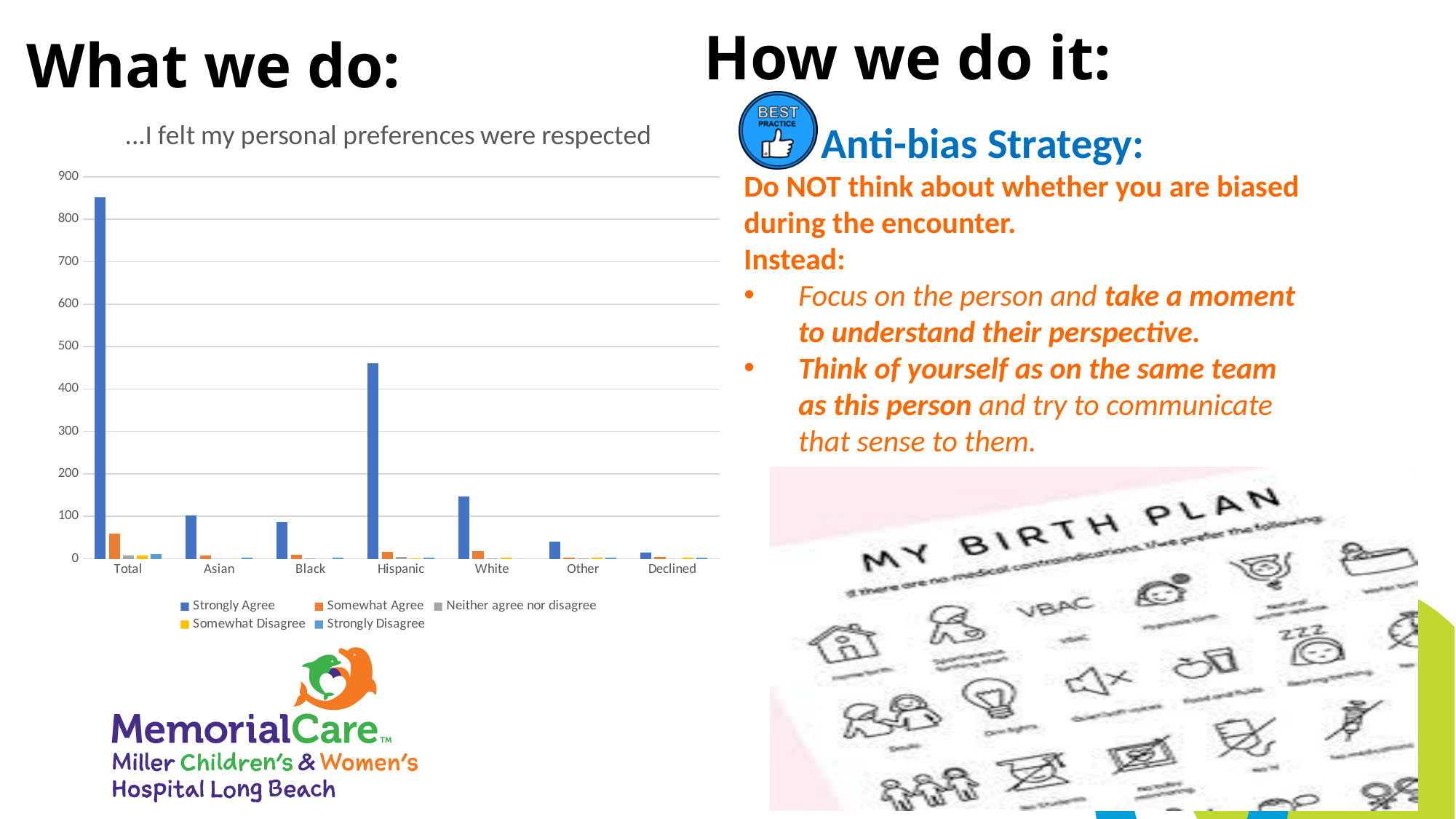
Excluding Total, which category has the highest Strongly Agree value? Hispanic How many categories are shown along the x axis of the chart? 7 How many series does the chart's legend list? 5 Which category has the highest Strongly Agree value in the chart? Total Which is larger, the Strongly Agree value for Hispanic or for White? Hispanic What kind of chart is shown under the heading 'What we do:'? bar chart Which category has the lowest Strongly Agree value in the chart? Declined Is the Strongly Agree value for Black greater or less than 100? less What is the title of the chart on the slide? ...I felt my personal preferences were respected Which series is shown in blue in the chart's legend? Strongly Agree Is the Strongly Agree value for Hispanic greater or less than 400? greater Is the Strongly Agree value for Total greater or less than 800? greater